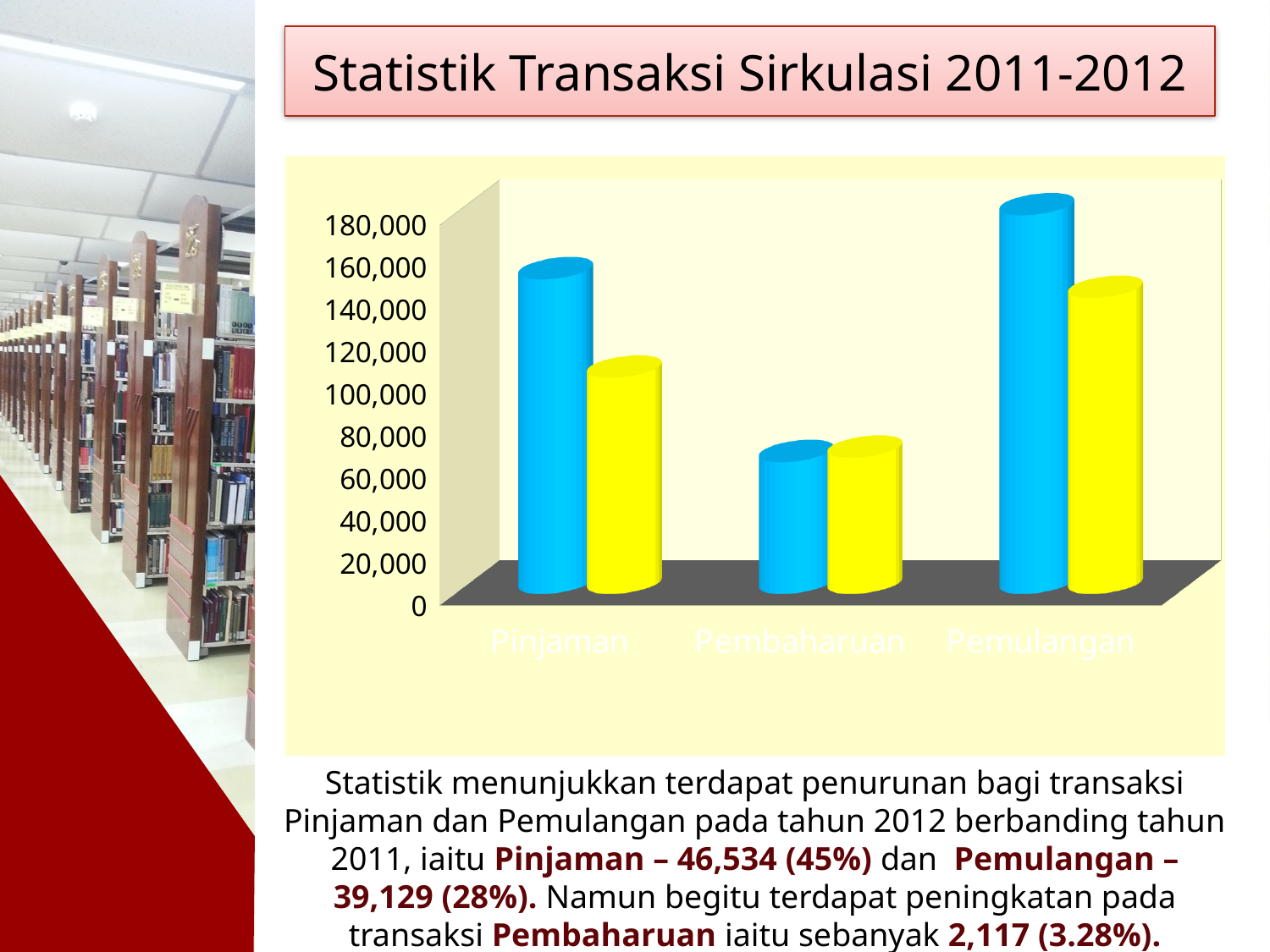
Is the value of the blue bar for Pemulangan greater or less than 160,000? greater How many categories are shown on the x axis of the chart? 3 For Pemulangan, which bar is taller, the blue bar or the yellow bar? blue Is the value of the blue bar for Pembaharuan greater or less than 100,000? less How many bars are shown for each category in the chart? 2 Which category has the tallest yellow bar? Pemulangan Which category has the shortest blue bar? Pembaharuan What is the title of the chart? Statistik Transaksi Sirkulasi 2011-2012 Which category has the tallest blue bar? Pemulangan For Pinjaman, which bar is taller, the blue bar or the yellow bar? blue What kind of chart is shown on the slide? bar chart Is the value of the blue bar for Pinjaman greater or less than 120,000? greater